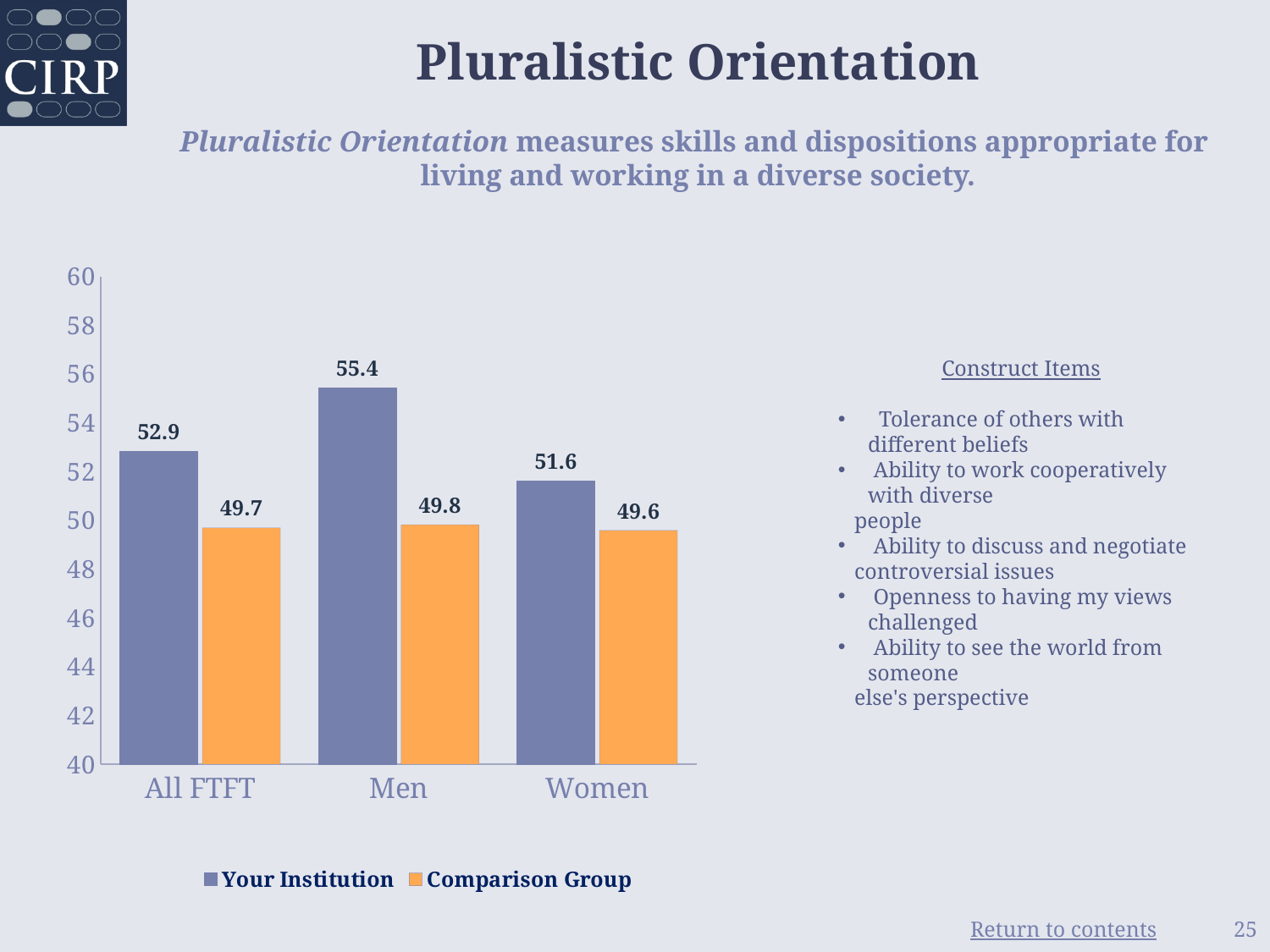
How many categories are shown on the x axis? 3 What is the Comparison Group value for Women? 49.6 Which category has the lowest Your Institution value? Women What is the difference between the Your Institution and Comparison Group values for All FTFT? 3.2 Which category has the highest Your Institution value? Men What is the difference between the Your Institution and Comparison Group values for Men? 5.6 Is the Comparison Group value for Men greater or less than 50? less What is the Your Institution value for Men? 55.4 What is the Your Institution value for All FTFT? 52.9 Which is larger for Women: Your Institution or Comparison Group? Your Institution How many series does the legend list? 2 What kind of chart is shown on the slide? bar chart